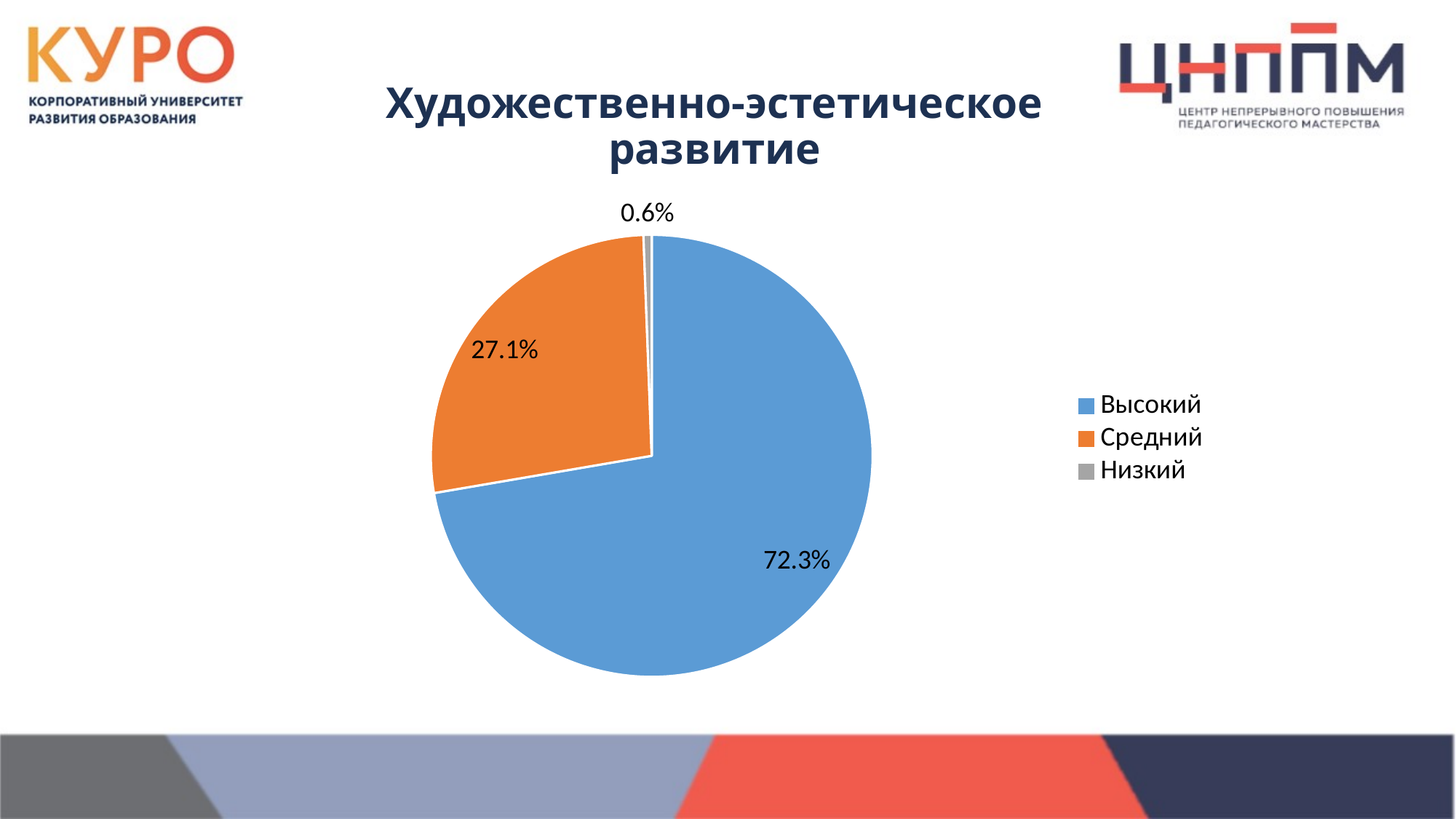
What is the difference in percentage points between Высокий and Средний? 45.2 What share of the pie does Высокий have? 72.3% What is the title of the chart? Художественно-эстетическое развитие Which category has the largest slice of the pie? Высокий What share of the pie does Низкий have? 0.6% How many slices does the pie chart have? 3 What kind of chart is shown on the slide? pie chart What share of the pie does Средний have? 27.1% What colour is the slice for Средний? orange What is the difference in percentage points between Средний and Низкий? 26.5 Which category has the smallest slice of the pie? Низкий Which is larger, the share for Средний or the share for Низкий? Средний